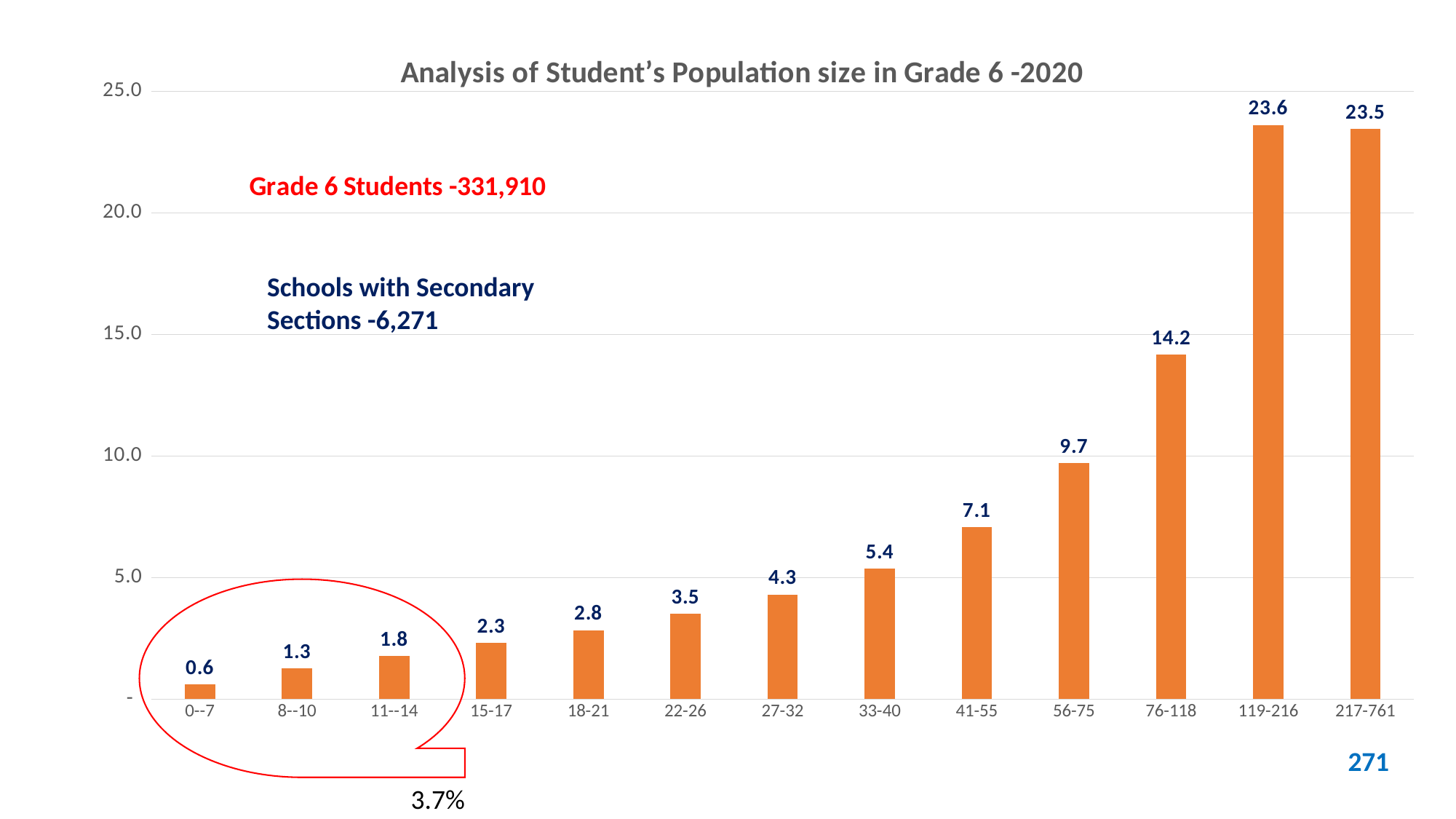
Which is larger, the value for 119-216 or the value for 217-761? 119-216 Do the values generally rise or fall from the 0--7 category to the 119-216 category? rise Which category has the highest value? 119-216 Is the value for 76-118 greater or less than 15.0? less What is the difference between the values for 56-75 and 41-55? 2.6 What is the value for the 76-118 category? 14.2 What is the value for the 0--7 category? 0.6 What is the value for the 33-40 category? 5.4 How many categories are shown on the x axis? 13 What kind of chart is shown on the slide? bar chart What is the title of the chart? Analysis of Student's Population size in Grade 6 -2020 Which category has the lowest value? 0--7